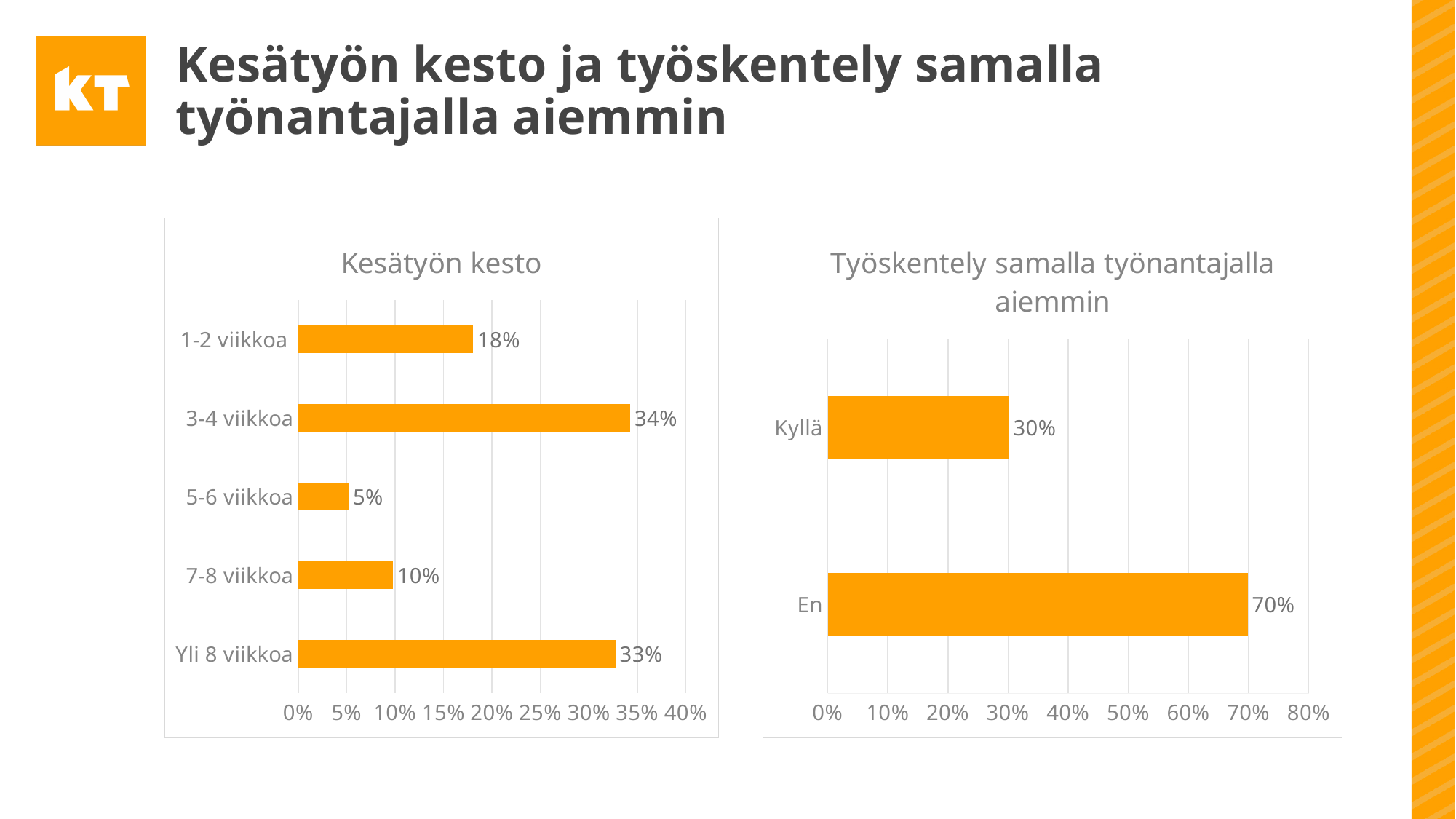
In the 'Kesätyön kesto' chart, what is the difference between the values for 1-2 viikkoa and 7-8 viikkoa? 8% In the 'Kesätyön kesto' chart, which category has the lowest value? 5-6 viikkoa In the 'Kesätyön kesto' chart, what is the value for 3-4 viikkoa? 34% In the 'Kesätyön kesto' chart, how many categories are shown? 5 In the 'Kesätyön kesto' chart, what is the value for Yli 8 viikkoa? 33% What kind of chart is the 'Työskentely samalla työnantajalla aiemmin' chart? Bar chart In the 'Työskentely samalla työnantajalla aiemmin' chart, what is the difference between the values for En and Kyllä? 40% In the 'Työskentely samalla työnantajalla aiemmin' chart, what is the value for Kyllä? 30% In the 'Työskentely samalla työnantajalla aiemmin' chart, which category has the highest value? En In the 'Kesätyön kesto' chart, is the value for 5-6 viikkoa greater or less than 10%? less What is the title of the chart on the left side of the slide? Kesätyön kesto In the 'Kesätyön kesto' chart, which is larger, the value for 1-2 viikkoa or the value for 7-8 viikkoa? 1-2 viikkoa